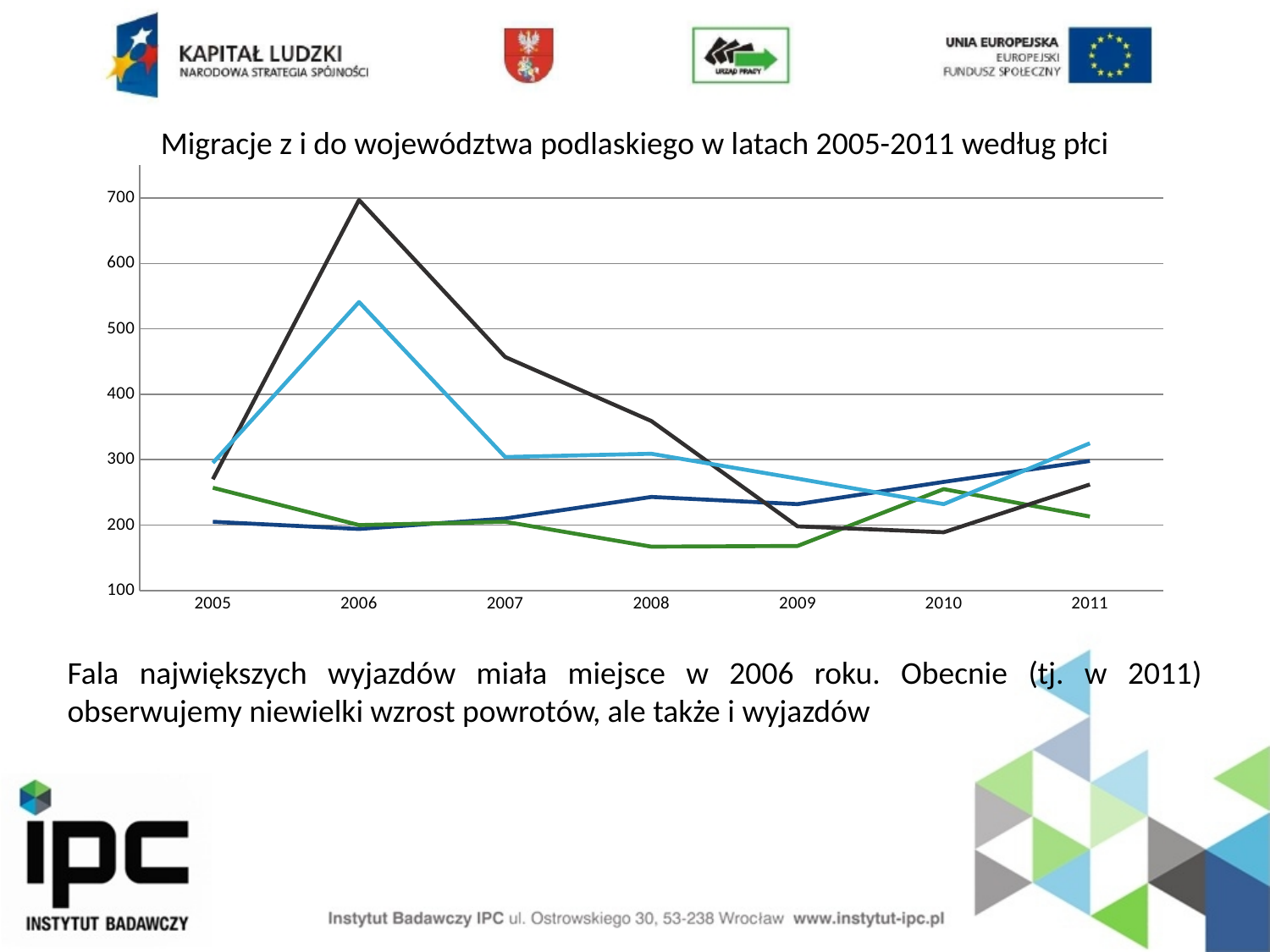
Is the value of the green line in 2005 greater or less than 300? less In which year does the light blue line reach its highest value? 2006 In 2006, which line has the higher value, the black line or the light blue line? the black line How many years are shown on the x axis of the chart? 7 How many lines are plotted on the chart? 4 What kind of chart is shown on the slide? line chart In which year does the black line reach its highest value? 2006 What is the title of the chart? Migracje z i do województwa podlaskiego w latach 2005-2011 według płci Is the value of the light blue line in 2006 greater or less than 500? greater Does the black line rise or fall between 2006 and 2010? fall Is the value of the black line in 2006 greater or less than 600? greater